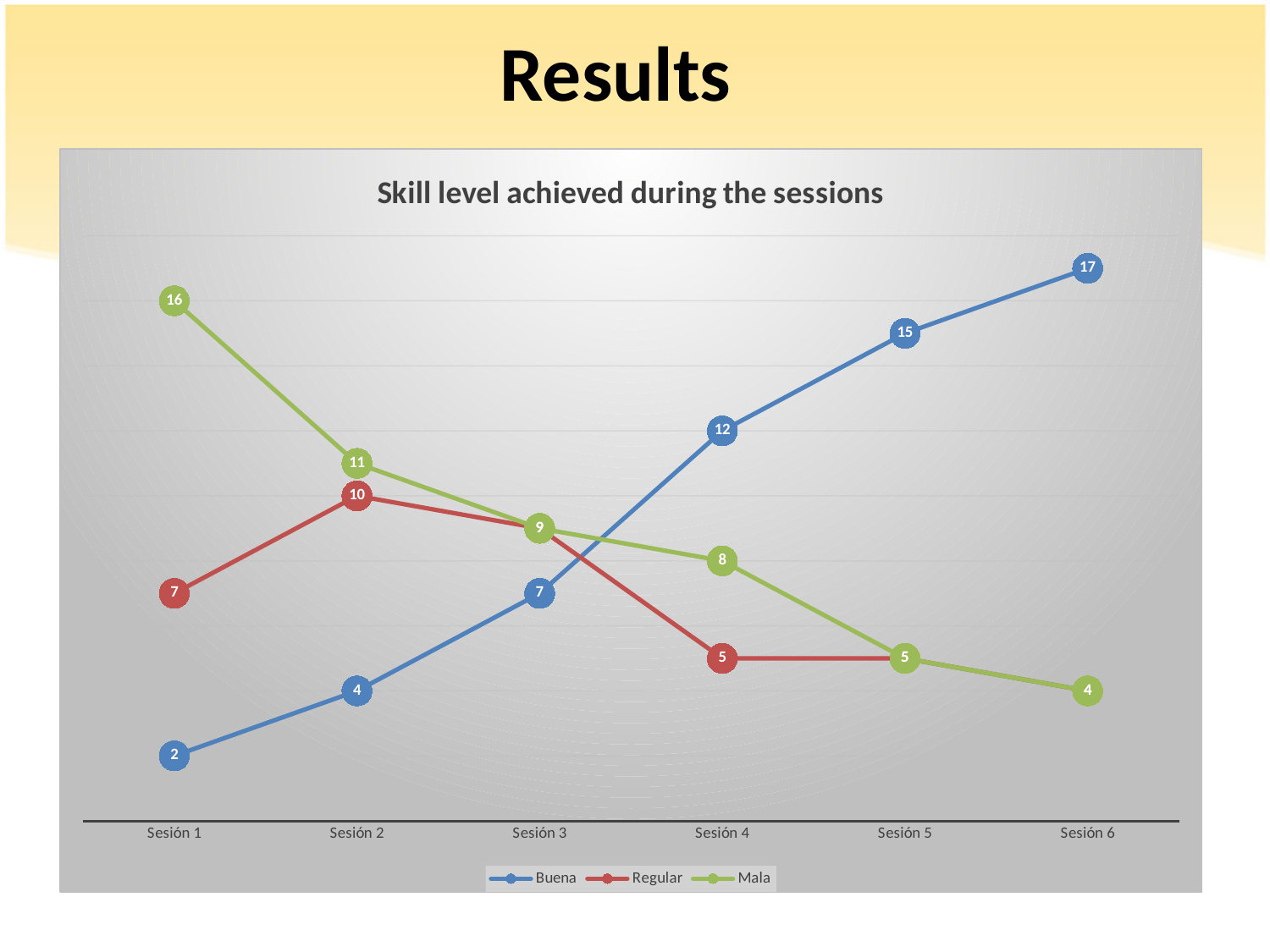
At Sesión 4, which series has the larger value, Buena or Mala? Buena Does the Buena series rise or fall from Sesión 1 to Sesión 6? rise At which session does Mala reach its lowest value? Sesión 6 What is the title of the chart? Skill level achieved during the sessions How many sessions are plotted along the x axis? 6 What is the value for Mala at Sesión 1? 16 What is the value for Buena at Sesión 6? 17 How many series does the legend list? 3 At which session does Buena reach its highest value? Sesión 6 What is the difference between the Buena value at Sesión 6 and at Sesión 1? 15 What is the value for Regular at Sesión 2? 10 What kind of chart is shown on the slide? line chart